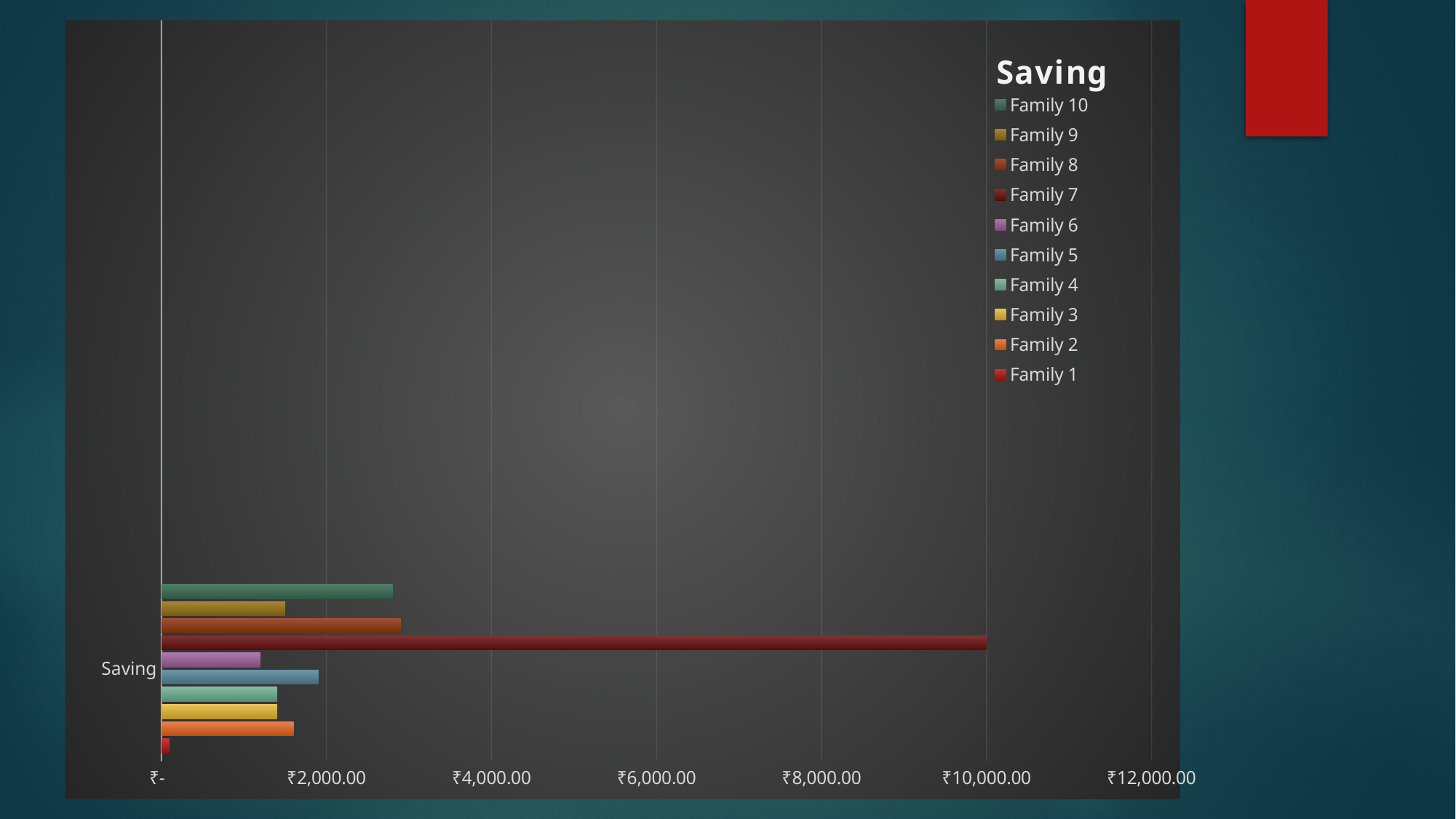
What is the saving value for Family 7? ₹10,000.00 How many series does the legend list? 10 How many categories are plotted on the vertical axis? 1 What kind of chart is shown on the slide? bar chart Which family has the highest saving? Family 7 What is the title of the chart? Saving Is the saving for Family 6 greater or less than ₹2,000.00? less Which family has the lowest saving? Family 1 Is the saving for Family 10 greater or less than ₹2,000.00? greater Is the saving for Family 9 greater or less than ₹2,000.00? less Which is larger, the saving for Family 10 or for Family 9? Family 10 Which is larger, the saving for Family 8 or for Family 6? Family 8